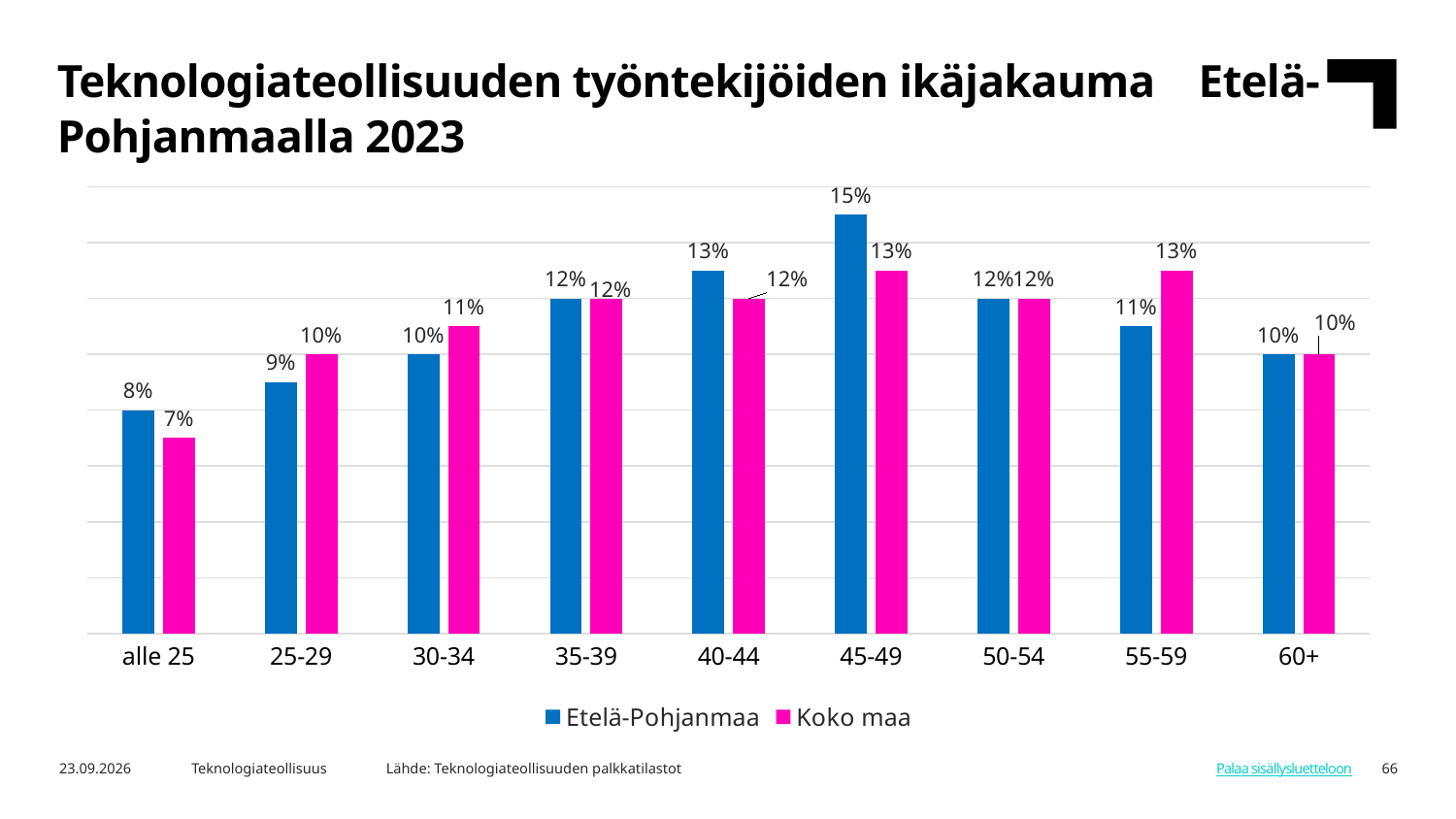
What is the value for Koko maa in the 55-59 age group? 13% What is the value for Etelä-Pohjanmaa in the 25-29 age group? 9% How many age groups are shown on the x axis? 9 Which series is shown in pink in the legend? Koko maa What is the value for Koko maa in the alle 25 age group? 7% In the 55-59 age group, which series has the larger value, Etelä-Pohjanmaa or Koko maa? Koko maa Which age group has the lowest value for Koko maa? alle 25 What is the difference between the Etelä-Pohjanmaa and Koko maa values in the 45-49 age group? 2 percentage points What kind of chart is shown on the slide? Bar chart How many series does the legend list? 2 What is the value for Etelä-Pohjanmaa in the 45-49 age group? 15% Which age group has the highest value for Etelä-Pohjanmaa? 45-49